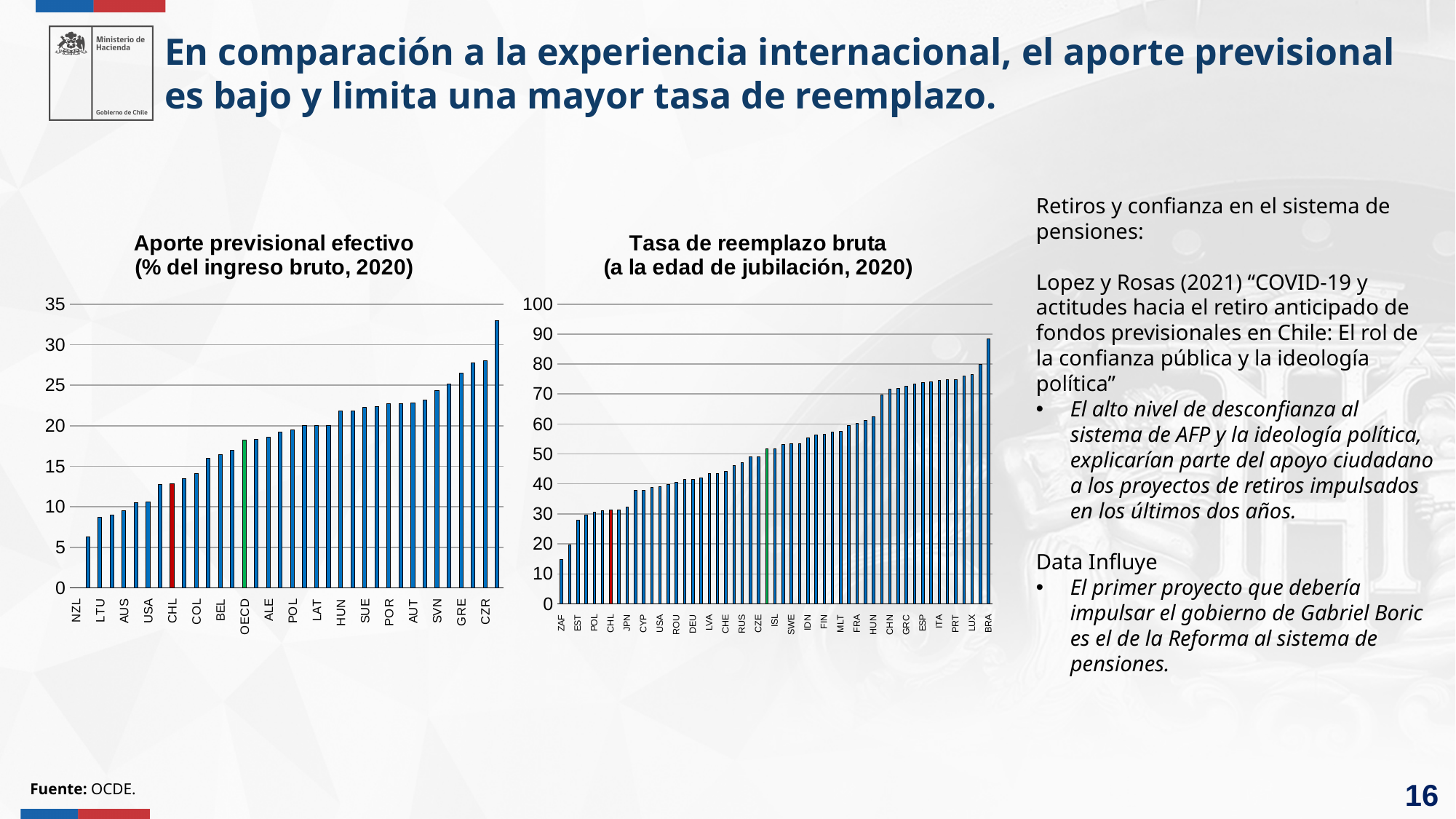
In the 'Aporte previsional efectivo' chart, do the values rise or fall from left to right along the x axis? rise In the 'Tasa de reemplazo bruta' chart, which labelled country has the lowest value? ZAF In the 'Tasa de reemplazo bruta' chart, is the value for BRA greater or less than 80? greater In the 'Aporte previsional efectivo' chart, what colour is the bar for CHL? red What kind of chart is the 'Aporte previsional efectivo' chart on the left? bar chart In the 'Aporte previsional efectivo' chart, is the value for CHL greater or less than 15? less In the 'Aporte previsional efectivo' chart, which labelled country has the highest value? CZR In the 'Tasa de reemplazo bruta' chart, which labelled country has the highest value? BRA In the 'Aporte previsional efectivo' chart, which is larger, the value for CHL or the value for OECD? OECD In the 'Tasa de reemplazo bruta' chart, is the value for ZAF greater or less than 20? less In the 'Aporte previsional efectivo' chart, which labelled country has the lowest value? NZL